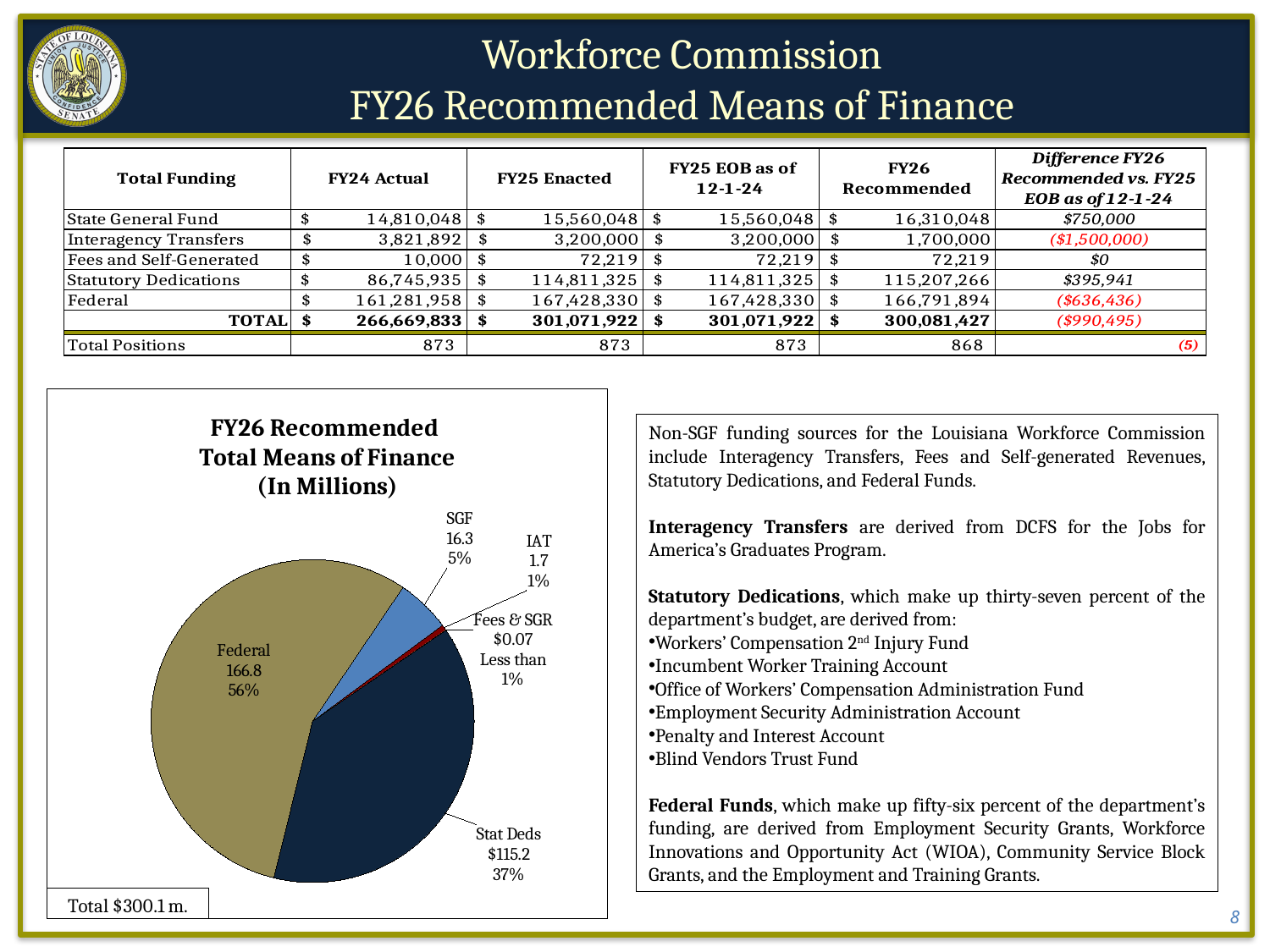
What is the value shown for SGF in the pie chart? 16.3 What is the value shown for Stat Deds in the pie chart? $115.2 What share of the pie does Stat Deds represent? 37% What kind of chart is shown on the slide? pie chart How many slices does the pie chart have? 5 What is the value shown for Federal in the pie chart? 166.8 What is the title of the pie chart? FY26 Recommended Total Means of Finance (In Millions) Which slice of the pie chart is the largest? Federal Which is larger in the pie chart, SGF or IAT? SGF Which slice of the pie chart is the smallest? Fees & SGR What is the value shown for IAT in the pie chart? 1.7 What share of the pie does Federal represent? 56%